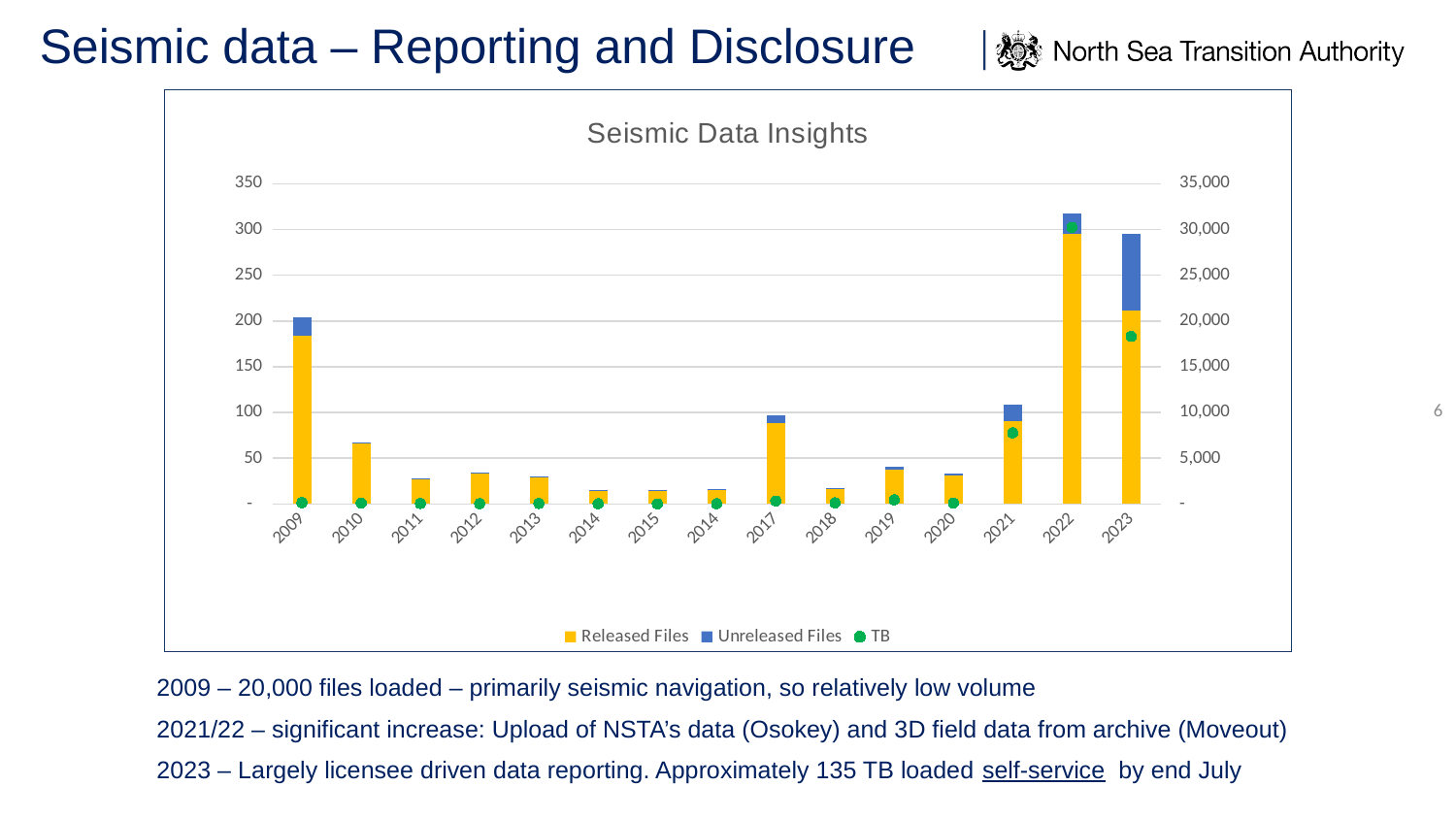
Which year has the taller total bar, 2009 or 2010? 2009 Which year has the highest TB value (green marker)? 2022 How many year categories are shown on the x axis of the chart? 15 What colour represents Released Files in the chart? Yellow Which year has the tallest total bar in the chart? 2022 What kind of chart is shown on the slide? A combination chart: stacked bar chart (Released and Unreleased Files) with the TB series plotted as markers on a secondary axis Do the total bar heights rise or fall from 2009 to 2011? Fall How many series does the chart legend list? 3 What is the title of the chart? Seismic Data Insights Which year has the taller total bar, 2017 or 2018? 2017 Which year has the largest Unreleased Files segment? 2023 Which year has the taller total bar, 2021 or 2023? 2023